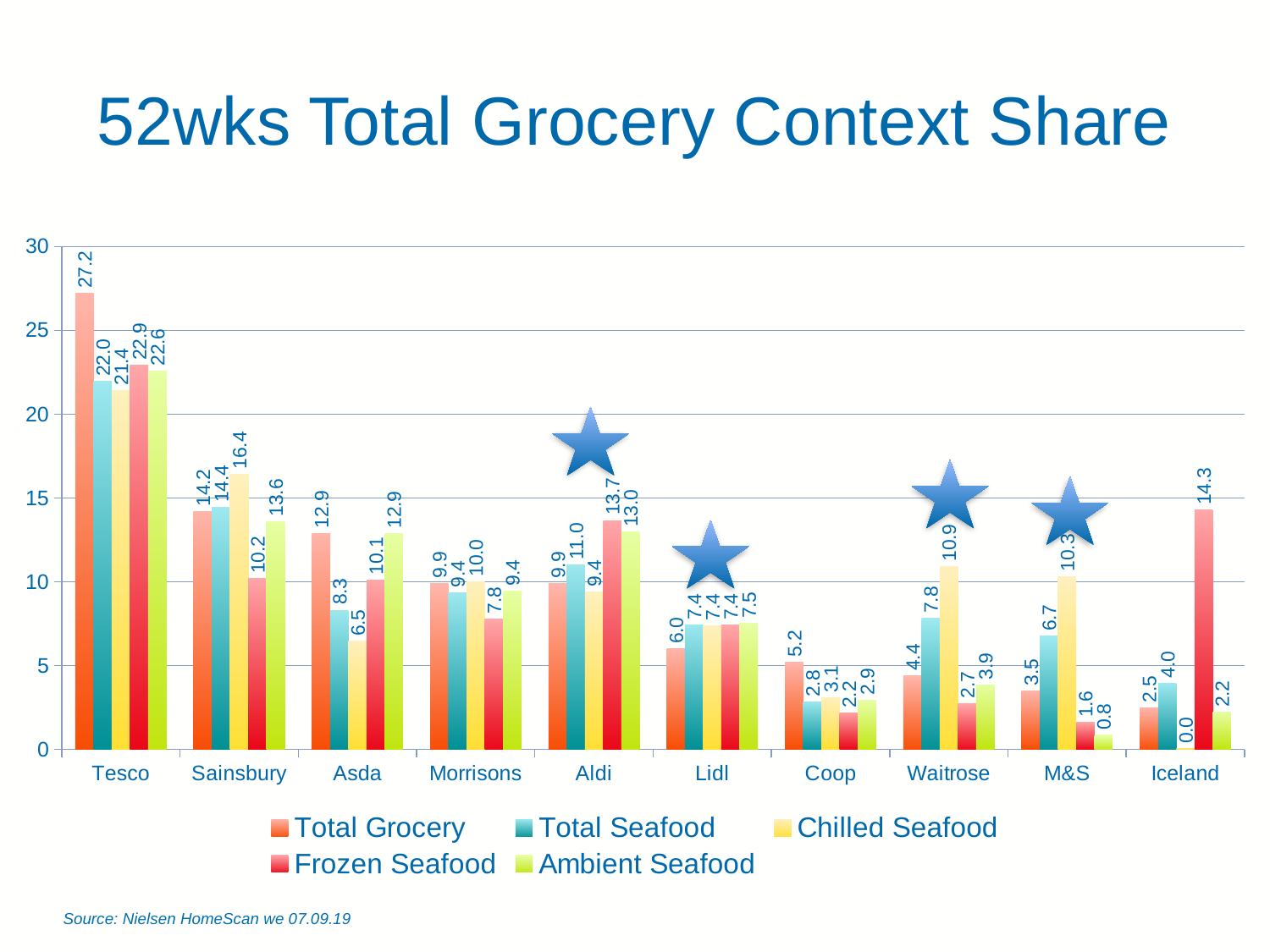
What is the Ambient Seafood value for M&S? 0.8 What is the source cited at the bottom of the slide? Nielsen HomeScan we 07.09.19 What is the Frozen Seafood value for Iceland? 14.3 What is the difference between the Chilled Seafood and Frozen Seafood values for Sainsbury? 6.2 How many series does the legend list? 5 What is the Chilled Seafood value for Waitrose? 10.9 What is the Total Grocery value for Tesco? 27.2 Which is larger for Aldi: Total Seafood or Frozen Seafood? Frozen Seafood Which retailer has the lowest Chilled Seafood value? Iceland What kind of chart is shown on the slide? Bar chart Which retailer has the highest Total Grocery value? Tesco How many retailers are shown on the x axis? 10